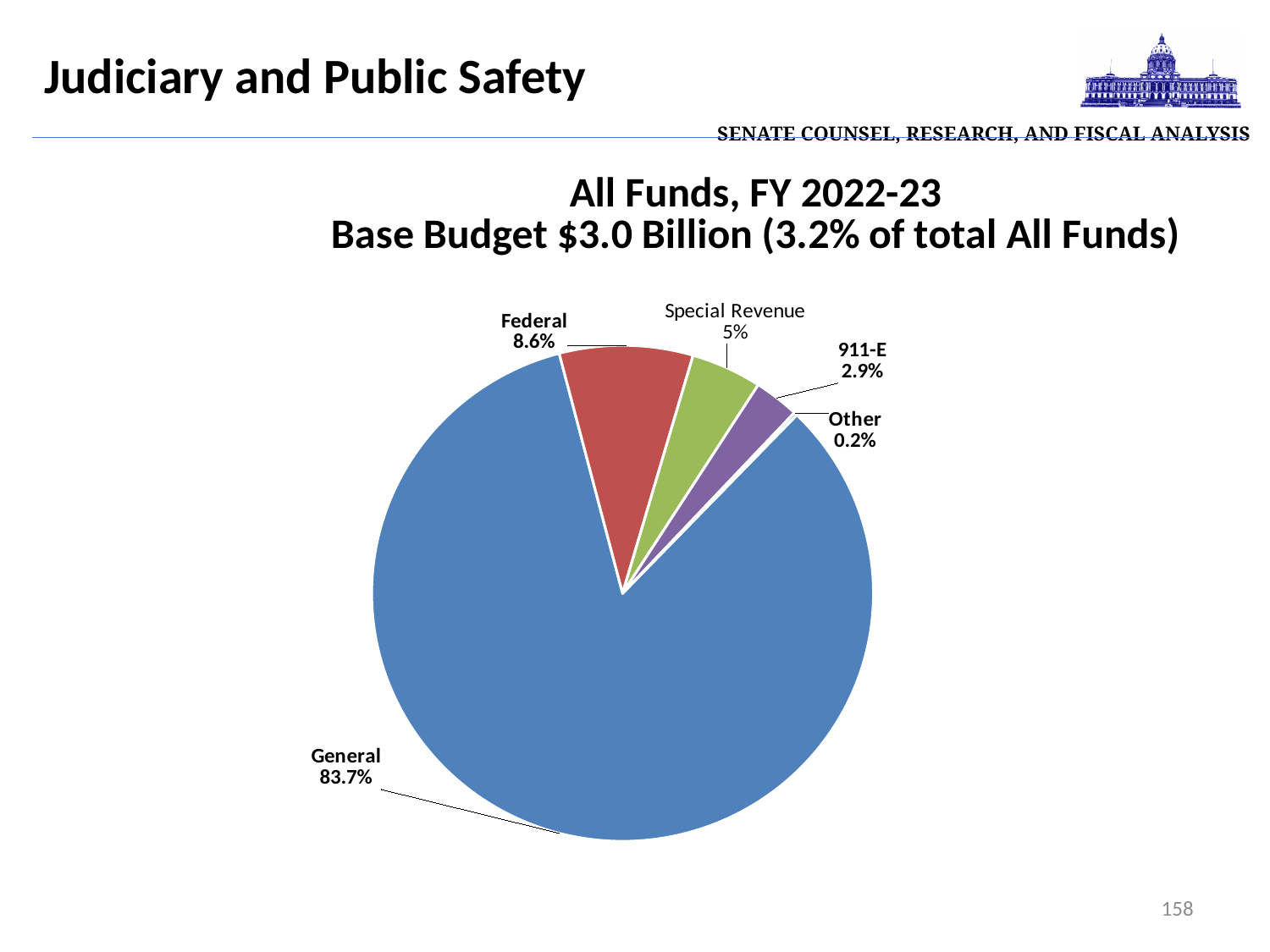
What share of the pie does the General slice represent? 83.7% Which slice of the pie is the smallest? Other What percentage is shown for 911-E? 2.9% How many slices does the pie chart have? 5 What kind of chart is shown on the slide? pie chart What is the title of the chart? All Funds, FY 2022-23 Base Budget $3.0 Billion (3.2% of total All Funds) Which is larger, the Federal slice or the Special Revenue slice? Federal What percentage is shown for the Federal slice? 8.6% What percentage is shown for Special Revenue? 5% What is the difference in percentage points between the Federal slice and the 911-E slice? 5.7 Which slice of the pie is the largest? General What percentage is shown for the Other slice? 0.2%